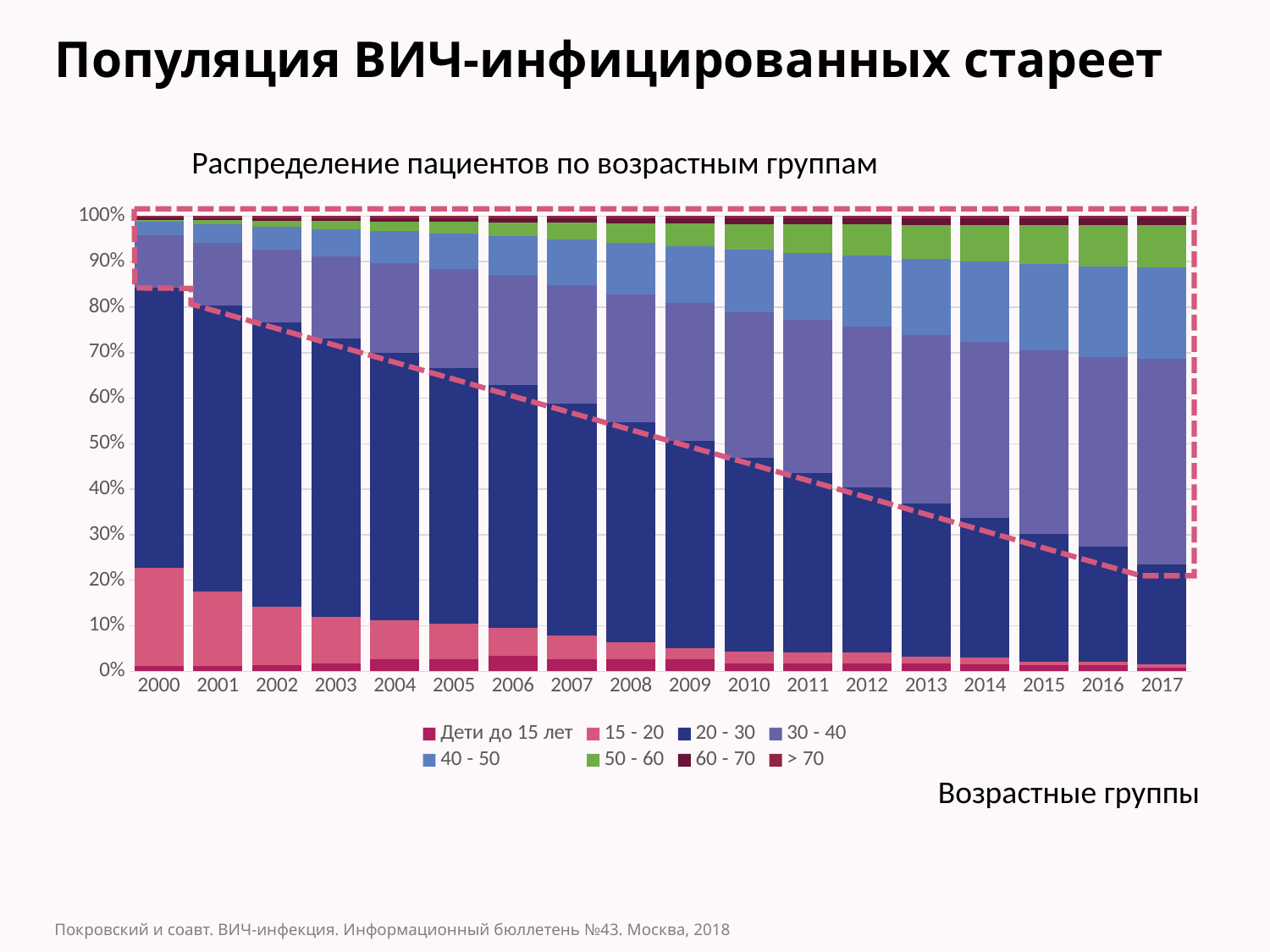
What is the first year shown on the x axis? 2000 Is the share of the 20 - 30 age group in 2000 greater or less than 50%? greater Does the share of the 30 - 40 age group rise or fall from 2000 to 2017? rise What is the title of the chart? Распределение пациентов по возрастным группам Does the share of the 20 - 30 age group rise or fall from 2000 to 2017? fall How many series does the chart legend list? 8 Is the share of the 20 - 30 age group larger in 2000 or in 2017? 2000 In 2017, which age group has the larger share: 20 - 30 or 30 - 40? 30 - 40 Is the share of the 20 - 30 age group in 2017 greater or less than 30%? less Is the share of the 15 - 20 age group in 2000 greater or less than 10%? greater What kind of chart is shown on the slide? stacked bar chart How many years are shown along the x axis of the chart? 18